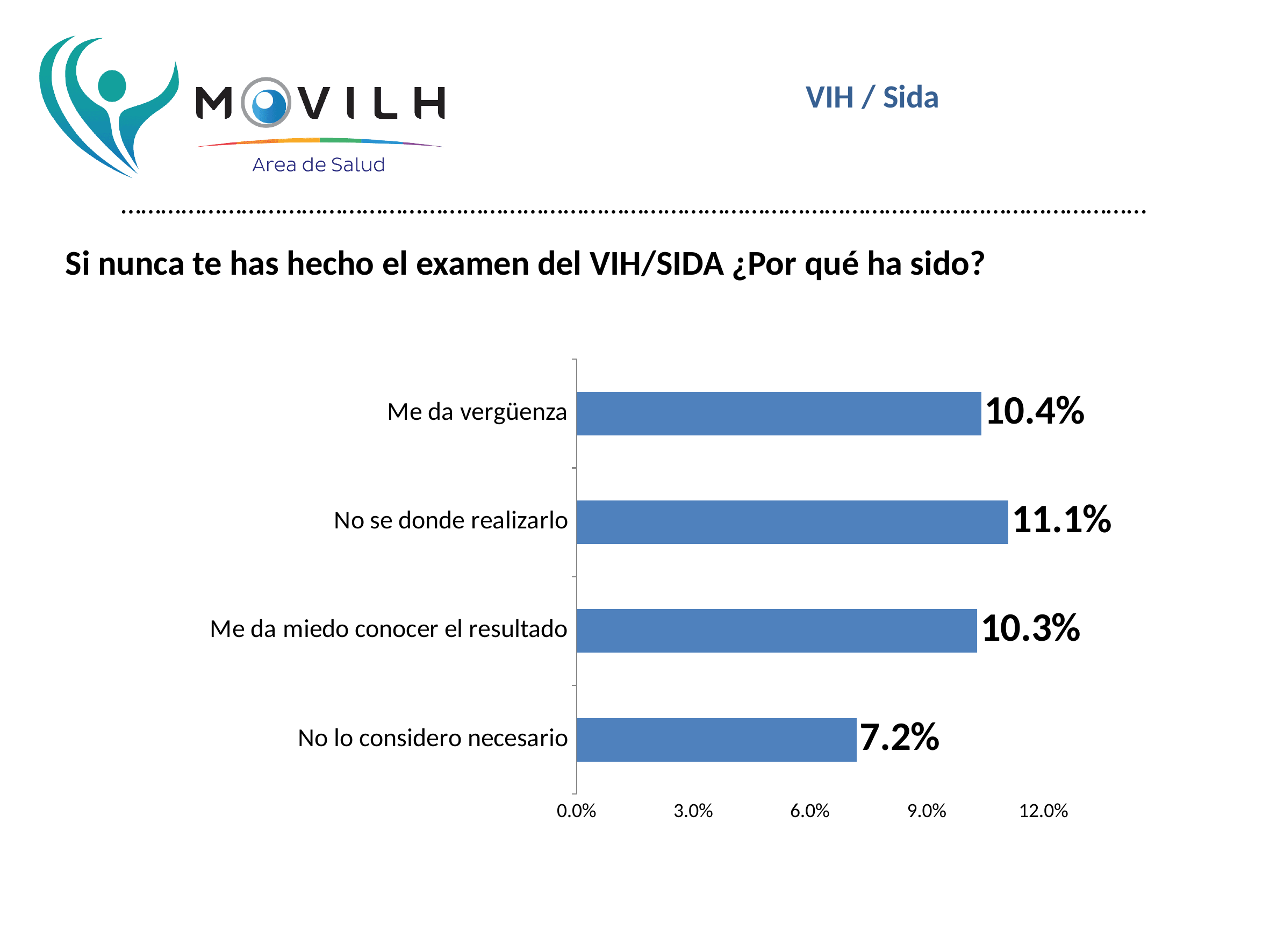
Which category has the highest value? No se donde realizarlo What is the value for "No lo considero necesario"? 7.2% What is the value for "Me da vergüenza"? 10.4% How many categories are shown in the chart? 4 What is the difference between the values for "No se donde realizarlo" and "No lo considero necesario"? 3.9% What is the value for "Me da miedo conocer el resultado"? 10.3% Which category has the lowest value? No lo considero necesario What is the value for "No se donde realizarlo"? 11.1% What is the difference between the values for "Me da vergüenza" and "Me da miedo conocer el resultado"? 0.1% What kind of chart is shown on the slide? bar chart Is the value for "No lo considero necesario" greater or less than 9.0%? less Which is larger, the value for "No se donde realizarlo" or the value for "No lo considero necesario"? No se donde realizarlo